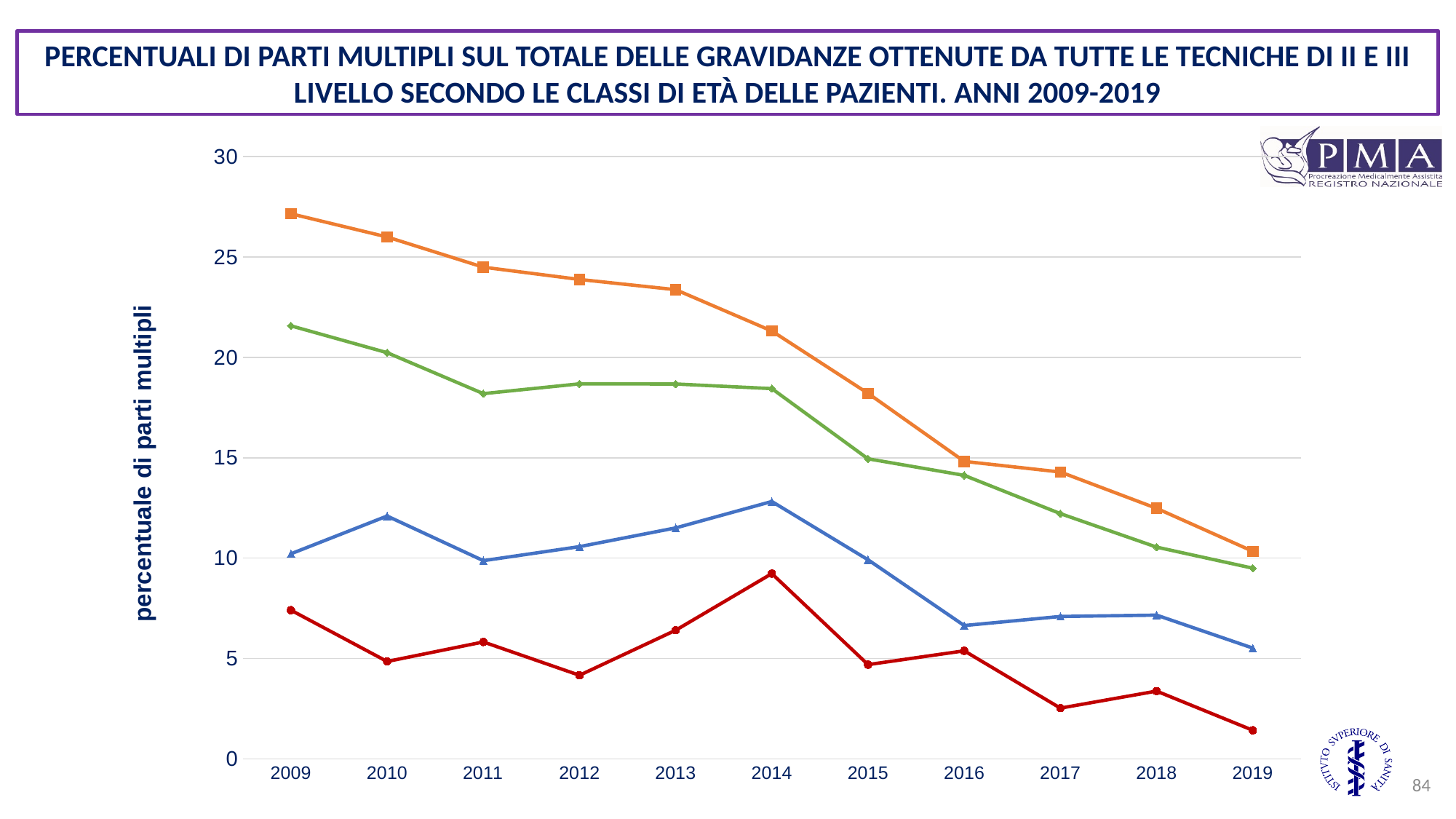
Is the value of the blue line in 2014 greater or less than 10? greater Does the orange line rise or fall from 2009 to 2019? fall Is the value of the orange line in 2009 greater or less than 25? greater How many years are shown on the x axis of the chart? 11 How many lines are plotted on the chart? 4 Which line has the highest value in 2009? orange line What kind of chart is shown on the slide? line chart Is the value of the green line in 2011 greater or less than 20? less What is the label of the y axis? percentuale di parti multipli In 2014, which line has the higher value, the blue line or the red line? blue line In which year does the red line reach its highest value? 2014